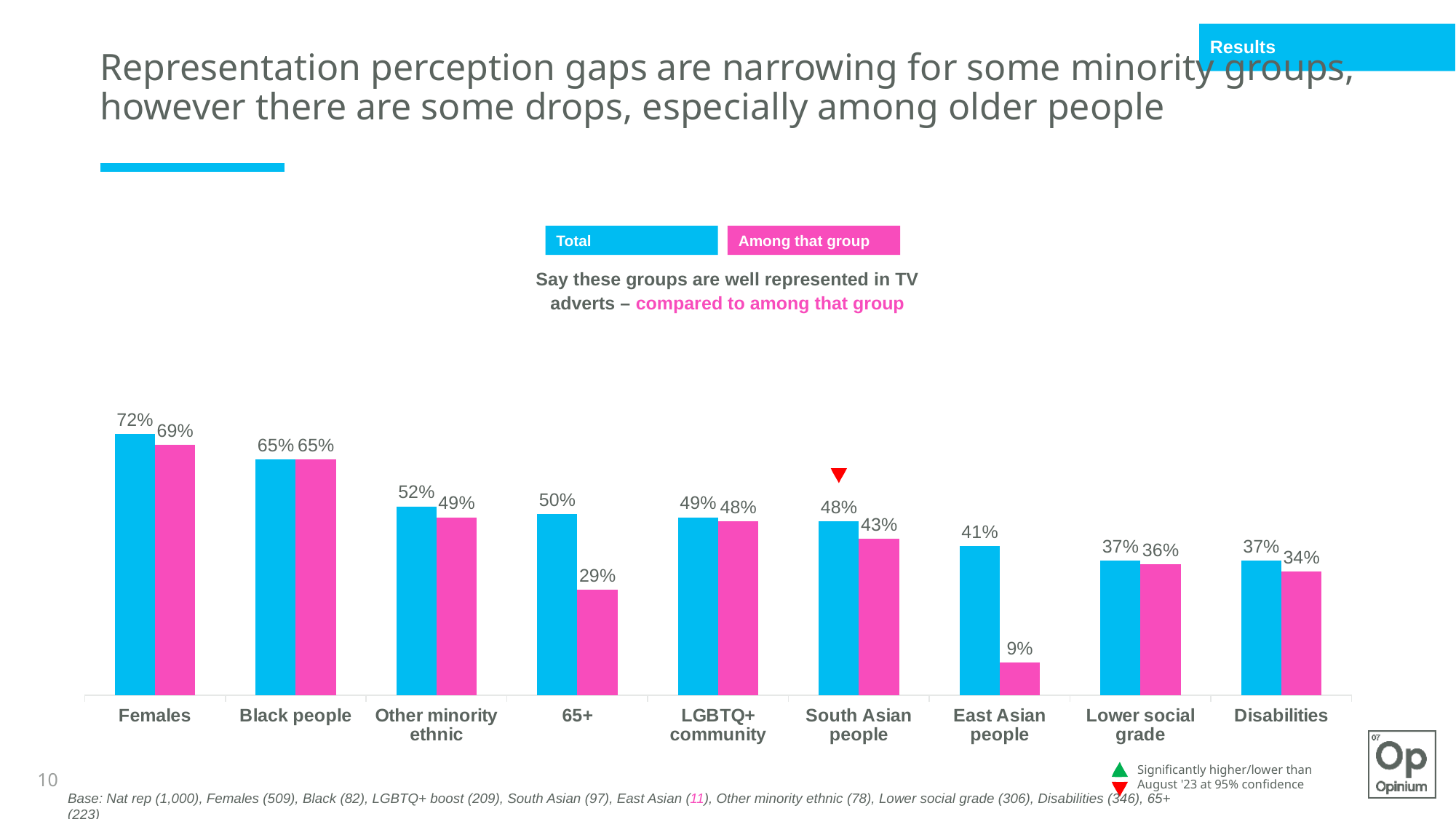
Which is larger for South Asian people: the Total value or the Among that group value? Total What is the difference between the Total and Among that group values for 65+? 21 percentage points Which category has the highest Total value? Females What kind of chart is shown on the slide? Bar chart Which category has the lowest Among that group value? East Asian people Which colour represents the Among that group series? Pink What is the Among that group value for 65+? 29% How many series does the legend list? 2 What is the Among that group value for East Asian people? 9% What is the Total value for Females? 72% What is the difference between the Total values for Females and Disabilities? 35 percentage points How many categories are shown on the x axis? 9